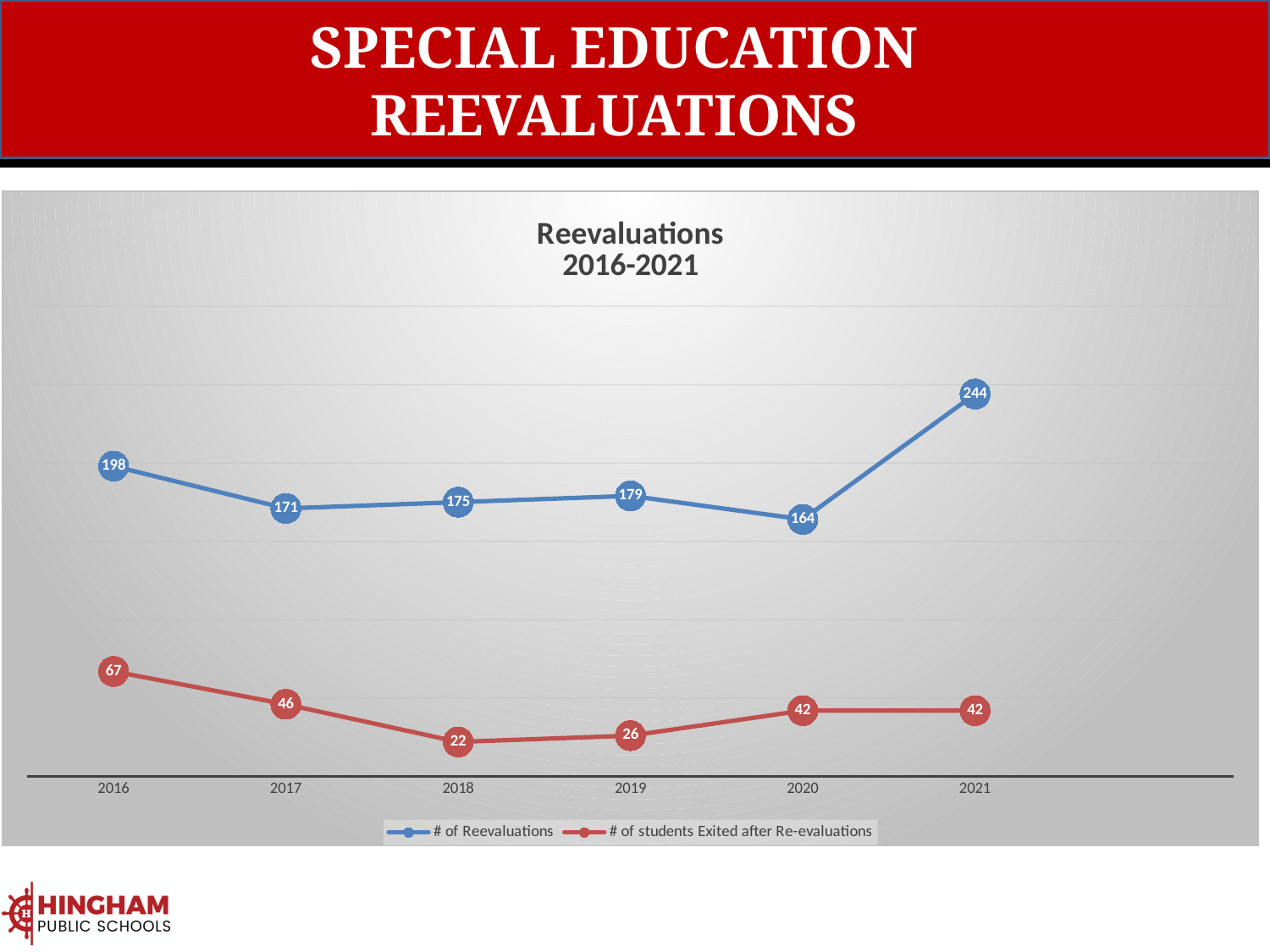
How many years are shown on the x axis? 6 How many series does the legend list? 2 What is the difference between the number of reevaluations in 2021 and in 2020? 80 What is the number of reevaluations in 2021? 244 How many students exited after re-evaluations in 2018? 22 What is the difference between the number of students exited after re-evaluations in 2016 and in 2017? 21 Which year has the lowest number of students exited after re-evaluations? 2018 Which year has the highest number of reevaluations? 2021 What is the number of reevaluations in 2016? 198 Which is larger: the number of reevaluations in 2017 or in 2019? 2019 What kind of chart is shown on the slide? Line chart Which year has the lowest number of reevaluations? 2020